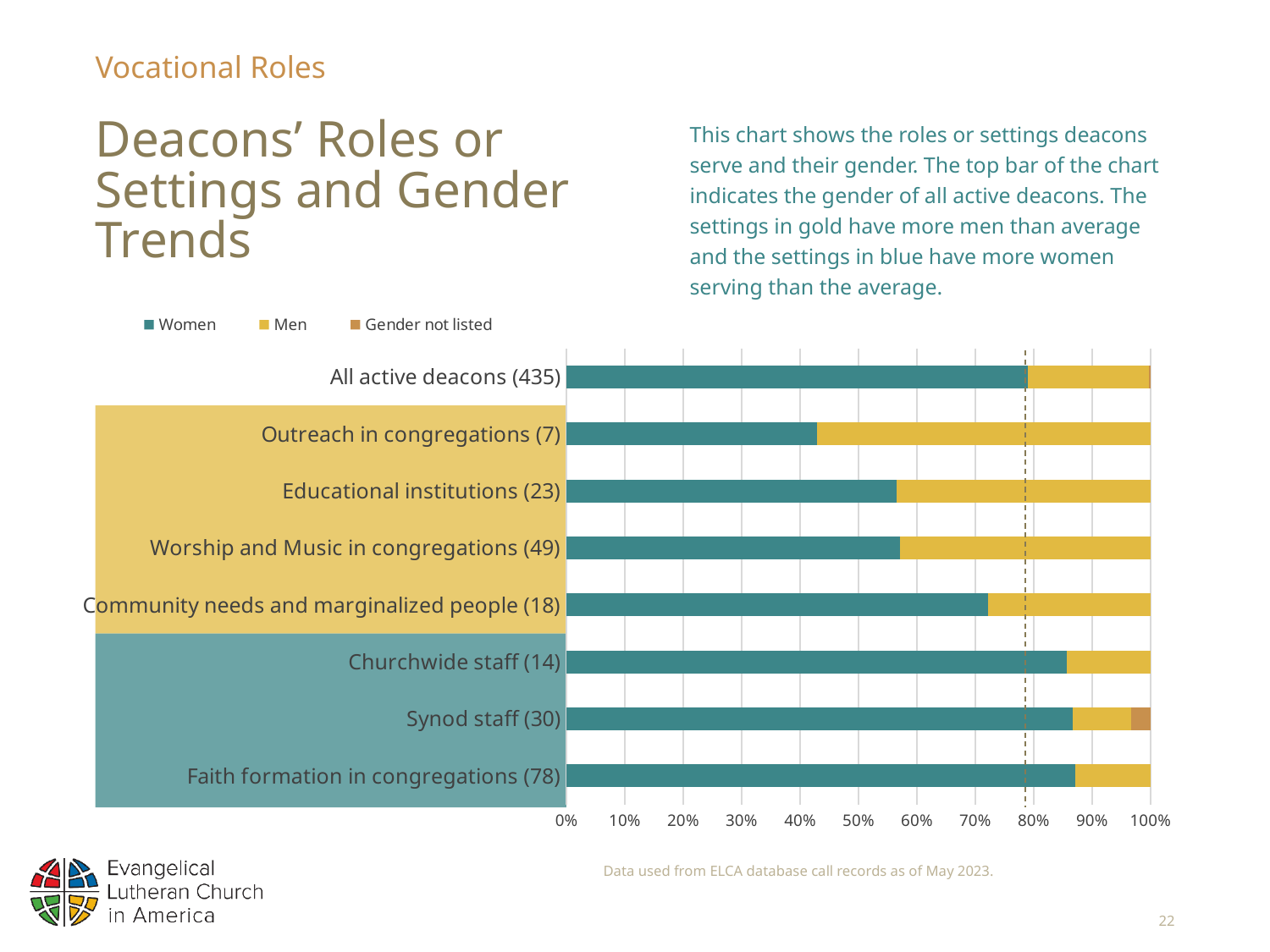
What are the three series listed in the legend? Women, Men, Gender not listed Is the share of women for Outreach in congregations greater or less than 50%? less Which role or setting has the highest share of men? Outreach in congregations (7) What kind of chart is shown on the slide? Stacked bar chart How many series does the legend list? 3 How many roles or settings (bars) are shown in the chart? 8 Which role or setting is the only one showing a 'Gender not listed' segment? Synod staff (30) Which has a larger share of women: Educational institutions or Churchwide staff? Churchwide staff Is the share of women for Churchwide staff greater or less than 80%? greater Which role or setting has the lowest share of women? Outreach in congregations (7) Is the share of women for Worship and Music in congregations greater or less than 60%? less